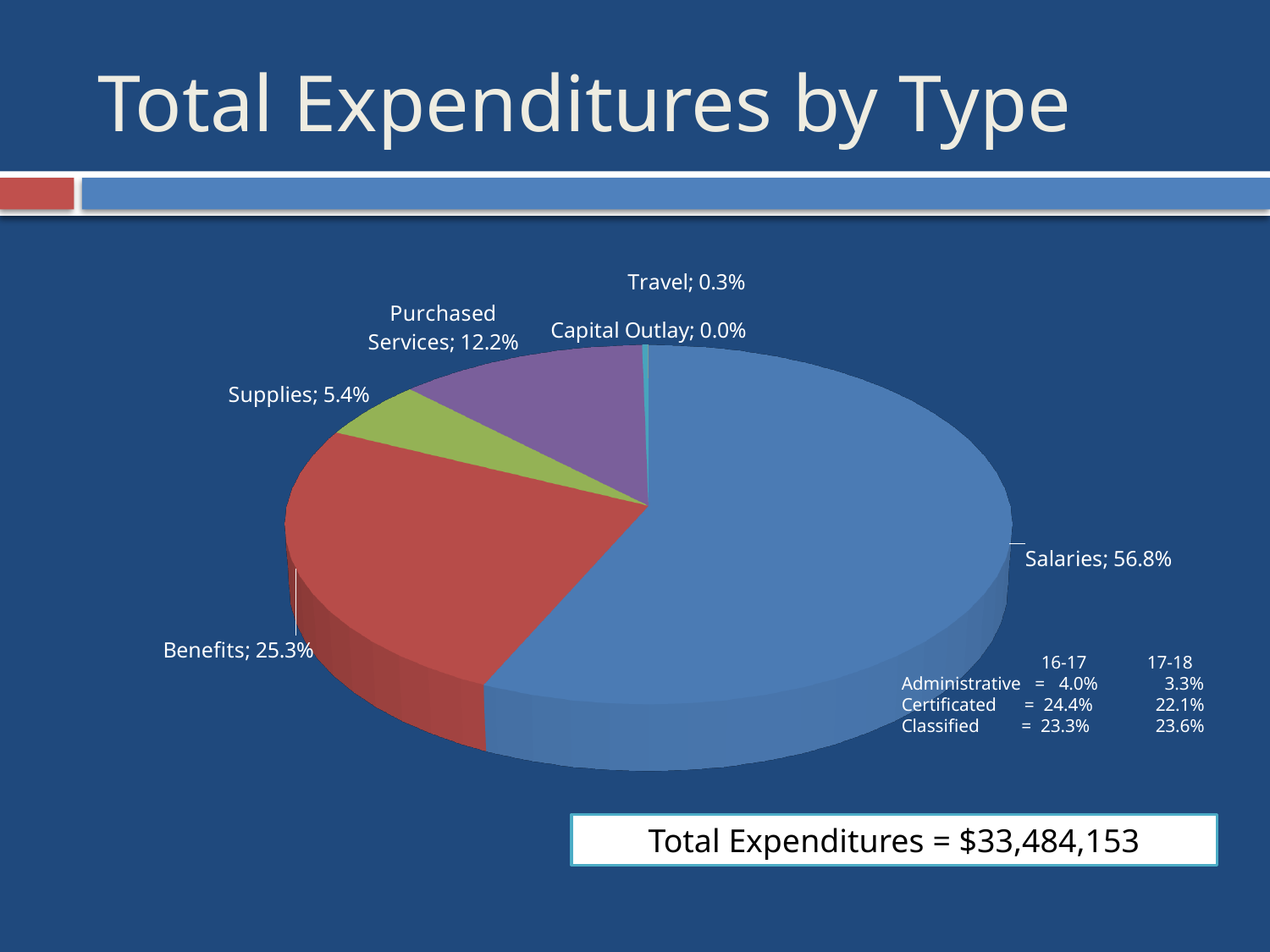
Which expenditure type has the largest share? Salaries What percentage is shown for Capital Outlay? 0.0% Which is larger, Purchased Services or Supplies? Purchased Services What share of total expenditures is Salaries? 56.8% What percentage is shown for Purchased Services? 12.2% What percentage is shown for Travel? 0.3% What share of total expenditures is Benefits? 25.3% What percentage is shown for Supplies? 5.4% How many expenditure types are shown in the pie chart? 6 What is the difference in percentage points between Salaries and Benefits? 31.5 What kind of chart is shown on the slide? Pie chart Which expenditure type has the smallest share? Capital Outlay